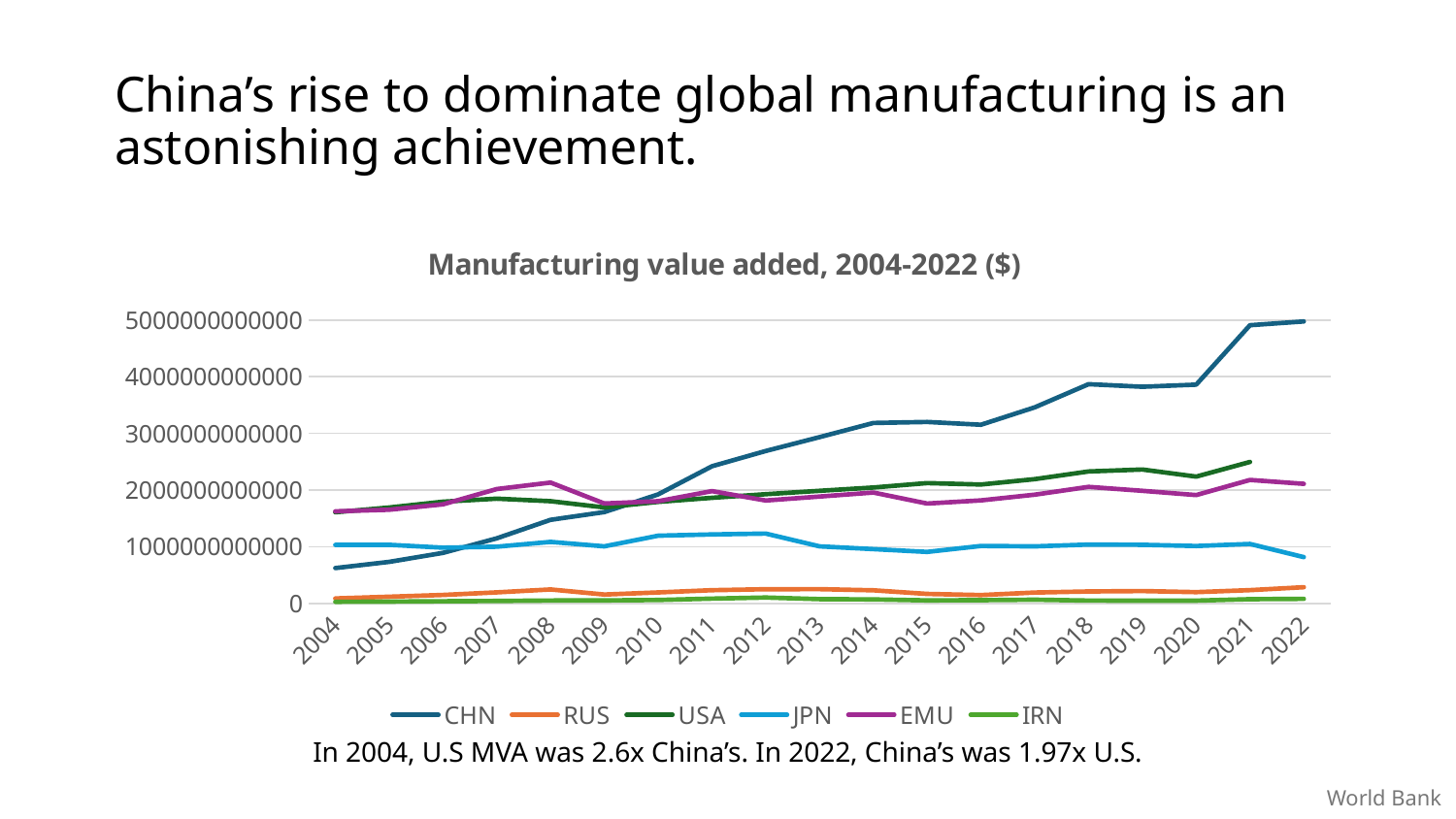
Is the value for JPN in 2022 greater or less than 1000000000000? less What is the title of the chart? Manufacturing value added, 2004-2022 ($) In 2004, which is larger, the value for USA or the value for CHN? USA Is the value for USA in 2004 greater or less than 1000000000000? greater Which series has the highest value in 2022? CHN How many series does the legend list? 6 Does the CHN line rise or fall from 2004 to 2022? rise What kind of chart is shown on the slide? line chart Is the value for CHN in 2022 greater or less than 4000000000000? greater In 2022, which is larger, the value for CHN or the value for USA? CHN How many years are plotted along the x axis? 19 Which series has the lowest value in 2022? IRN